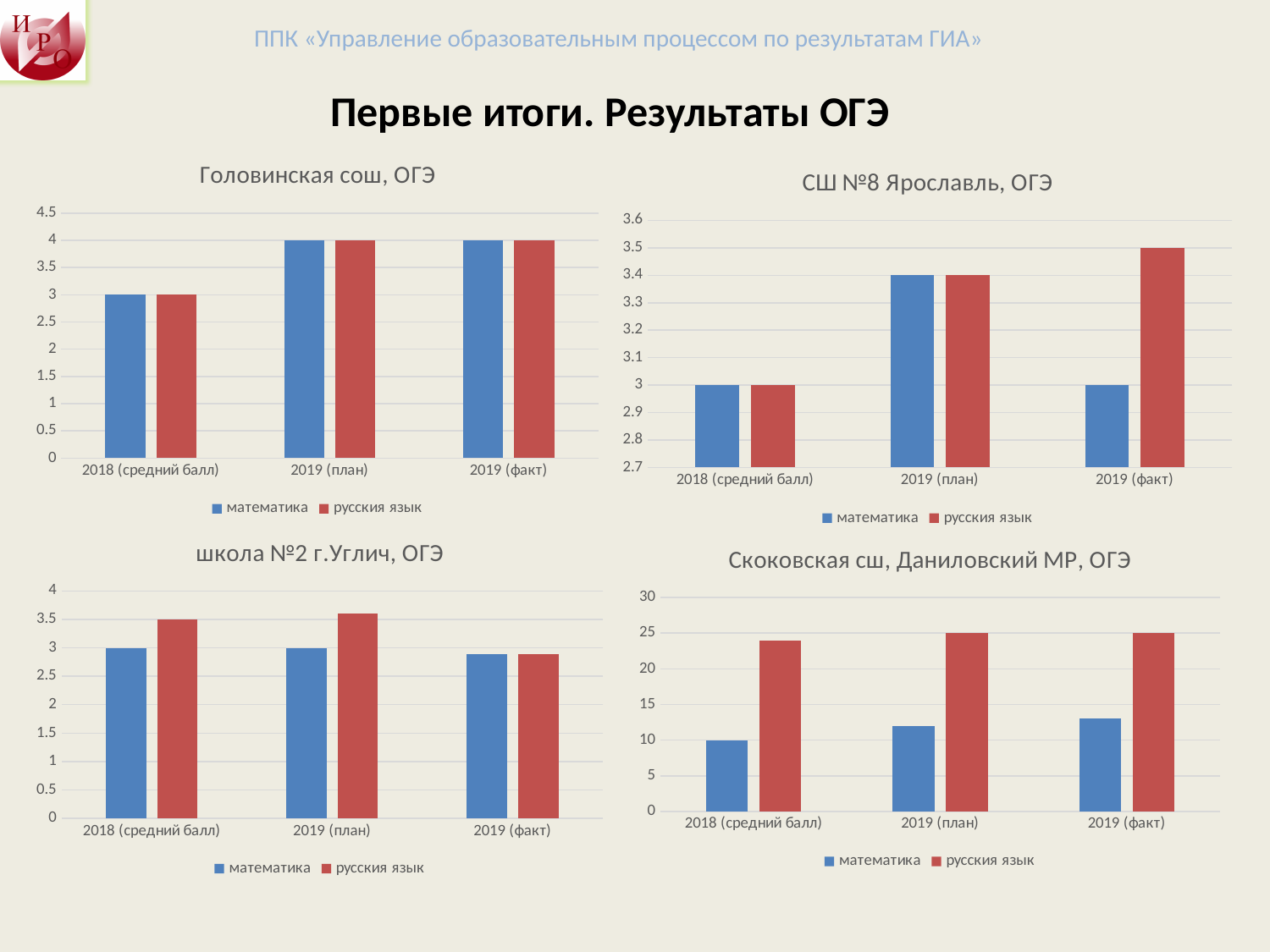
What kind of chart is the chart titled "Скоковская сш, Даниловский МР, ОГЭ"? bar chart In the chart titled "Скоковская сш, Даниловский МР, ОГЭ", what is the value for математика in 2018 (средний балл)? 10 In the chart titled "школа №2 г.Углич, ОГЭ", what is the value for русския язык in 2018 (средний балл)? 3.5 In the chart titled "СШ №8 Ярославль, ОГЭ", what is the value for русския язык in 2019 (факт)? 3.5 In the chart titled "Скоковская сш, Даниловский МР, ОГЭ", is the value for русския язык in 2018 (средний балл) greater or less than 20? greater In the chart titled "СШ №8 Ярославль, ОГЭ", what is the value for математика in 2019 (план)? 3.4 In the chart titled "СШ №8 Ярославль, ОГЭ", what is the difference between русския язык and математика in 2019 (факт)? 0.5 How many series does the legend list in the chart titled "Головинская сош, ОГЭ"? 2 In the chart titled "Головинская сош, ОГЭ", what is the value for математика in 2018 (средний балл)? 3 In the chart titled "Скоковская сш, Даниловский МР, ОГЭ", which series has the higher value in 2019 (факт), математика or русския язык? русския язык In the chart titled "школа №2 г.Углич, ОГЭ", is the value for математика in 2019 (факт) greater or less than 3? less In the chart titled "Головинская сош, ОГЭ", what is the value for русския язык in 2019 (план)? 4